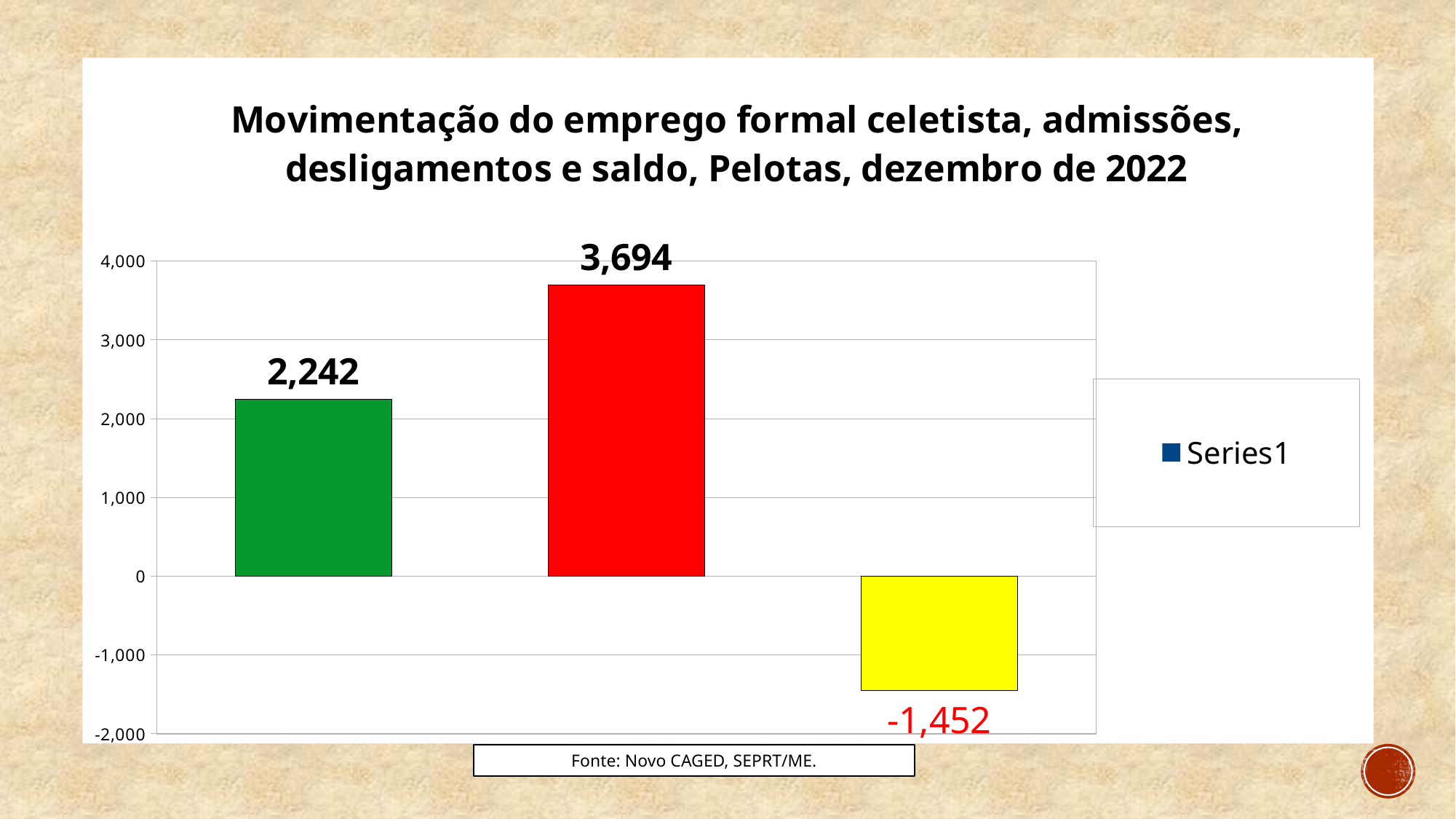
What kind of chart is shown on the slide? Bar chart Which is larger, the value of the green bar or the value of the red bar? The red bar Which bar has the highest value? The red bar (3,694) What is the value shown on the yellow bar (the third bar from the left)? -1,452 What is the difference between the red bar's value and the green bar's value? 1,452 What is the value shown on the red bar (the middle bar)? 3,694 Which bar has the lowest value? The yellow bar (-1,452) What is the value shown on the green bar (the first bar from the left)? 2,242 How many bars are plotted in the chart? 3 Is the value of the green bar greater or less than 2,000? greater What is the source cited below the chart? Fonte: Novo CAGED, SEPRT/ME. How many series does the legend list? 1